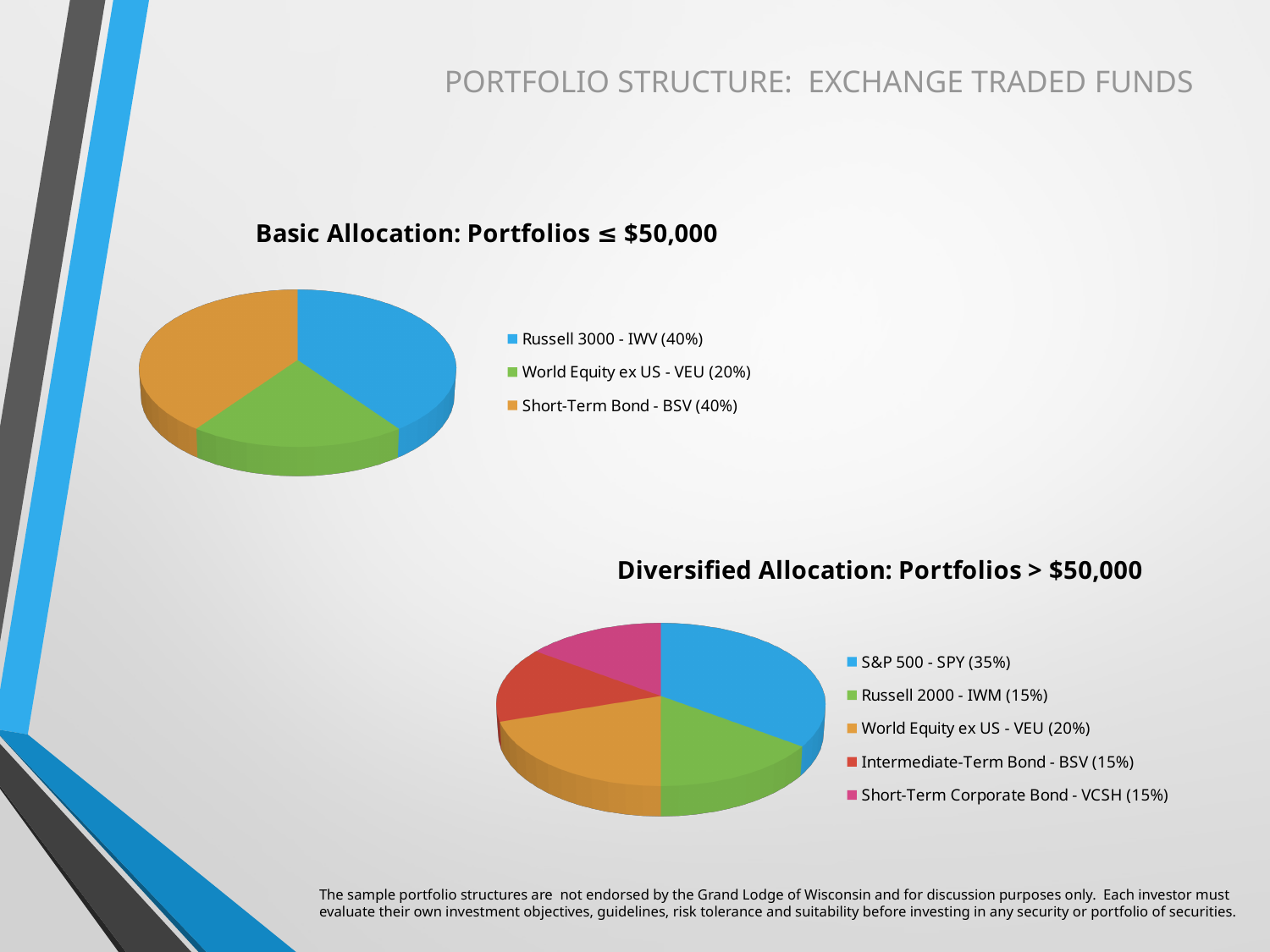
In the Basic Allocation chart, which holding has the smallest share? World Equity ex US - VEU How many slices does the Basic Allocation pie chart have? 3 In the Basic Allocation chart, what percentage is allocated to Short-Term Bond - BSV? 40% In the Diversified Allocation chart, which is larger: World Equity ex US - VEU or Russell 2000 - IWM? World Equity ex US - VEU In the Diversified Allocation chart, what is the difference between the S&P 500 - SPY share and the Intermediate-Term Bond - BSV share? 20% In the Basic Allocation chart, what share of the portfolio is allocated to World Equity ex US - VEU? 20% In the Diversified Allocation chart, what colour represents Short-Term Corporate Bond - VCSH? Pink In the Basic Allocation chart, what is the difference between the Russell 3000 - IWV share and the World Equity ex US - VEU share? 20% In the Diversified Allocation chart, what share is allocated to S&P 500 - SPY? 35% In the Diversified Allocation chart, which holding has the largest share? S&P 500 - SPY What type of chart is used for the Diversified Allocation? Pie chart How many holdings are shown in the Diversified Allocation pie chart? 5